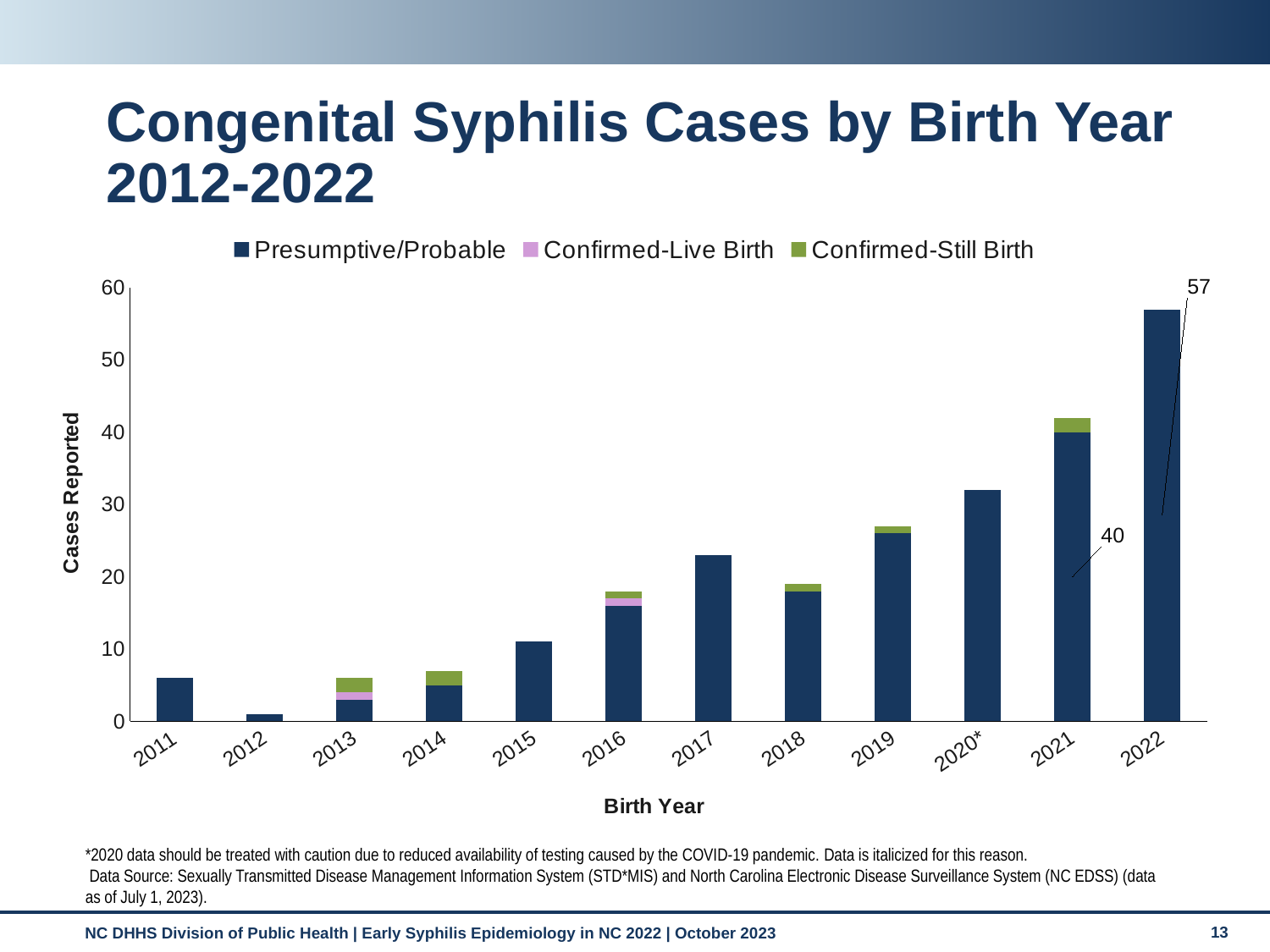
How many birth years are shown on the x axis? 12 Is the total value for 2020* greater or less than 30? greater Which birth year has the lowest total number of cases reported? 2012 How many series does the legend list? 3 Do the total cases reported generally rise or fall from 2011 to 2022? Rise Which birth year has more cases reported in total, 2019 or 2021? 2021 Is the total value for 2012 greater or less than 10? less What is the labeled value of the Presumptive/Probable bar for 2022? 57 Which birth year has the highest total number of cases reported? 2022 What is the labeled value of the Presumptive/Probable bar for 2021? 40 What is the difference between the labeled Presumptive/Probable values for 2022 and 2021? 17 What kind of chart is shown on the slide? Stacked bar chart